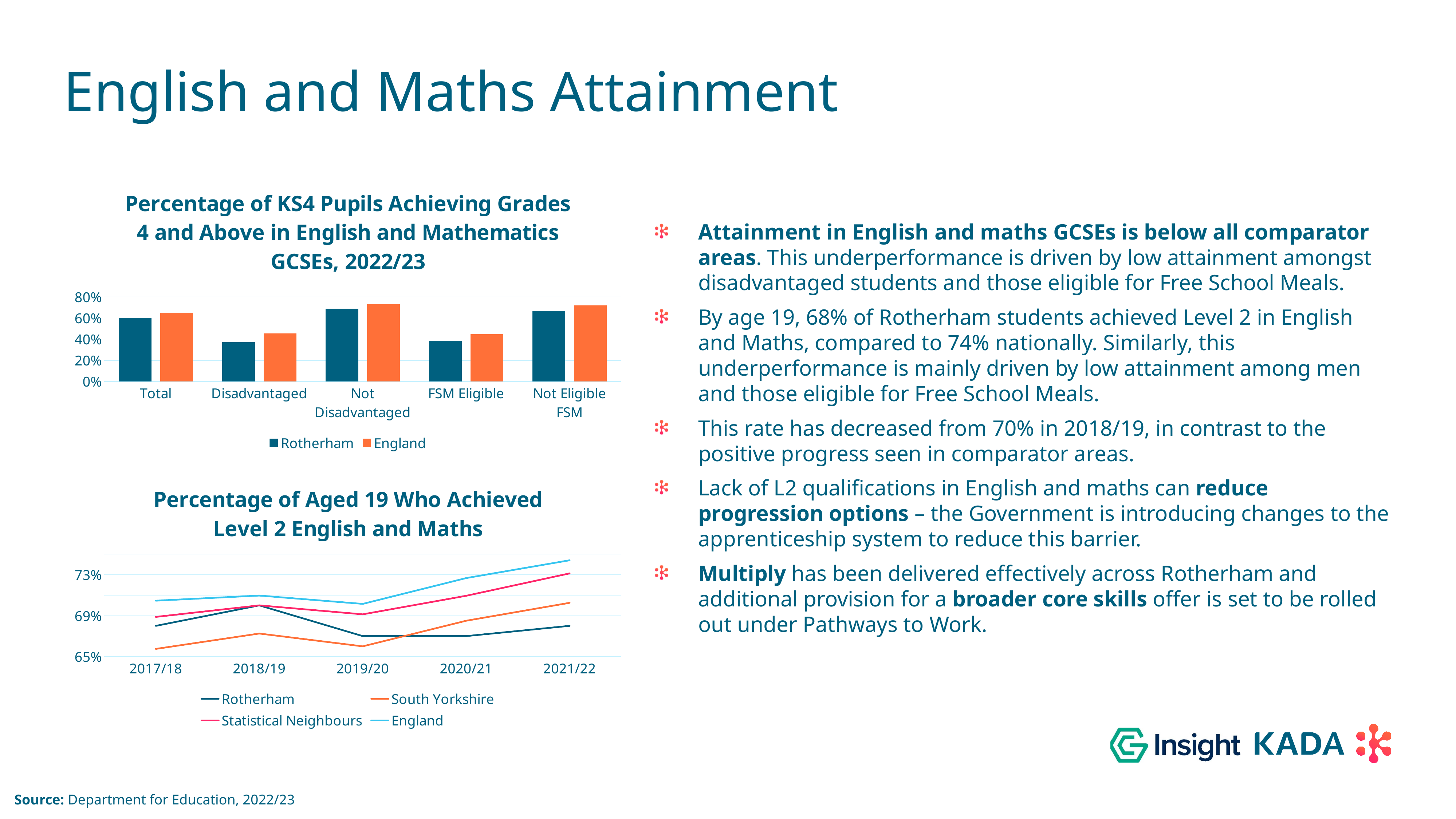
What kind of chart is the 'Percentage of KS4 Pupils Achieving Grades 4 and Above in English and Mathematics GCSEs, 2022/23' chart? Bar chart In the 'Percentage of Aged 19 Who Achieved Level 2 English and Maths' chart, which series has the lowest value in 2017/18? South Yorkshire What kind of chart is the 'Percentage of Aged 19 Who Achieved Level 2 English and Maths' chart? Line chart In the KS4 pupils bar chart, which is larger for the Total category, Rotherham or England? England How many series does the legend of the KS4 pupils bar chart list? 2 How many series does the legend of the 'Percentage of Aged 19 Who Achieved Level 2 English and Maths' chart list? 4 In the KS4 pupils bar chart, which colour represents England? Orange In the 'Percentage of Aged 19 Who Achieved Level 2 English and Maths' chart, which series has the highest value in 2021/22? England In the KS4 pupils bar chart, is the Rotherham value for Disadvantaged greater or less than 40%? less In the KS4 pupils bar chart, is the England value for Total greater or less than 60%? greater In the 'Percentage of Aged 19 Who Achieved Level 2 English and Maths' chart, is the Rotherham value for 2021/22 greater or less than 69%? less How many categories are shown on the x axis of the KS4 pupils bar chart? 5